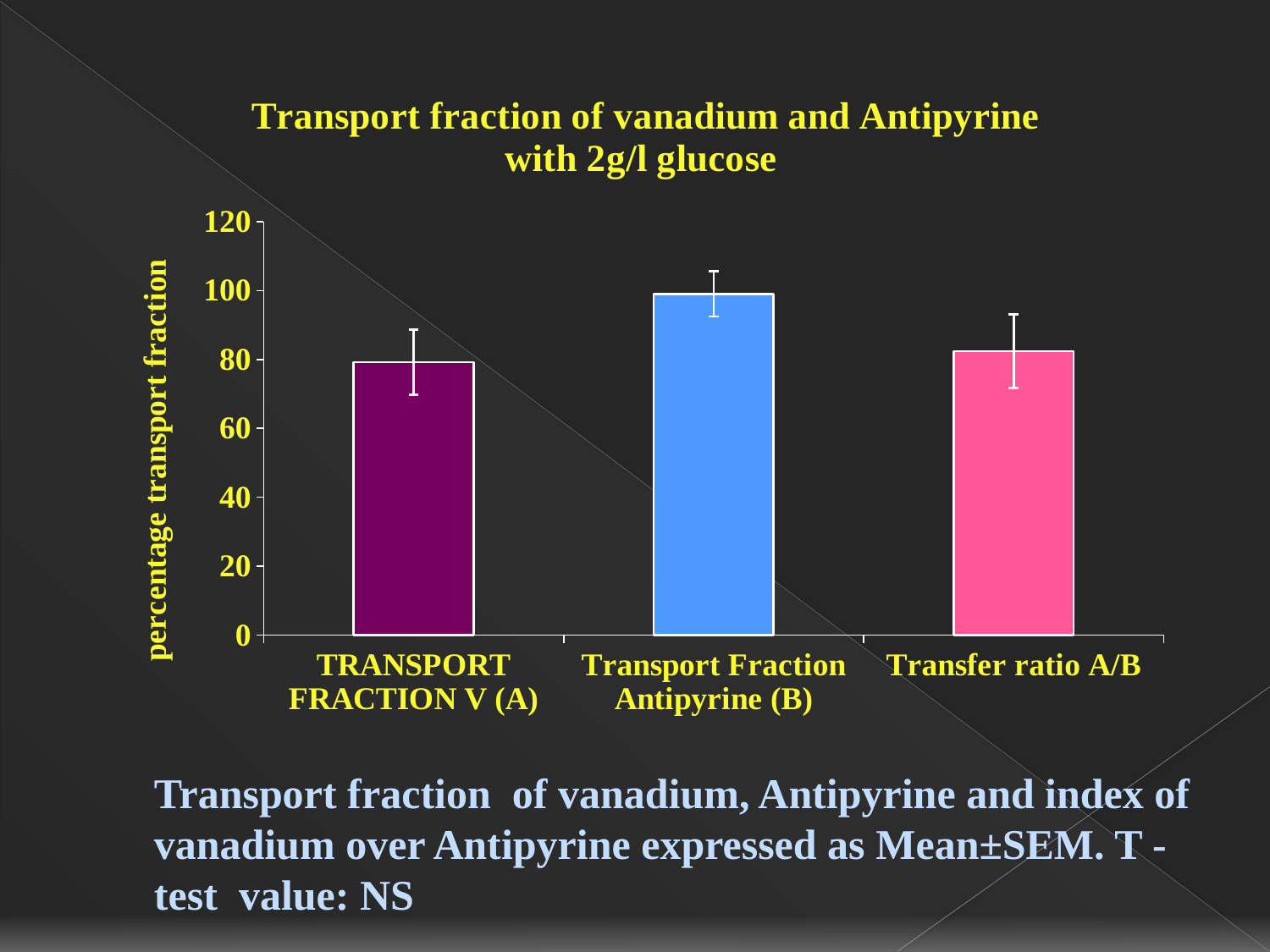
What is the label on the vertical axis of the chart? percentage transport fraction Is the value for Transport Fraction Antipyrine (B) greater or less than 80? greater What kind of chart is shown on the slide? bar chart Which is larger: the value for TRANSPORT FRACTION V (A) or the value for Transport Fraction Antipyrine (B)? Transport Fraction Antipyrine (B) Is the value for TRANSPORT FRACTION V (A) greater or less than 100? less What is the title of the chart? Transport fraction of vanadium and Antipyrine with 2g/l glucose Is the value for Transfer ratio A/B greater or less than 60? greater Which is larger: the value for Transport Fraction Antipyrine (B) or the value for Transfer ratio A/B? Transport Fraction Antipyrine (B) How many categories (bars) are plotted in the chart? 3 Which category has the highest bar in the chart? Transport Fraction Antipyrine (B)